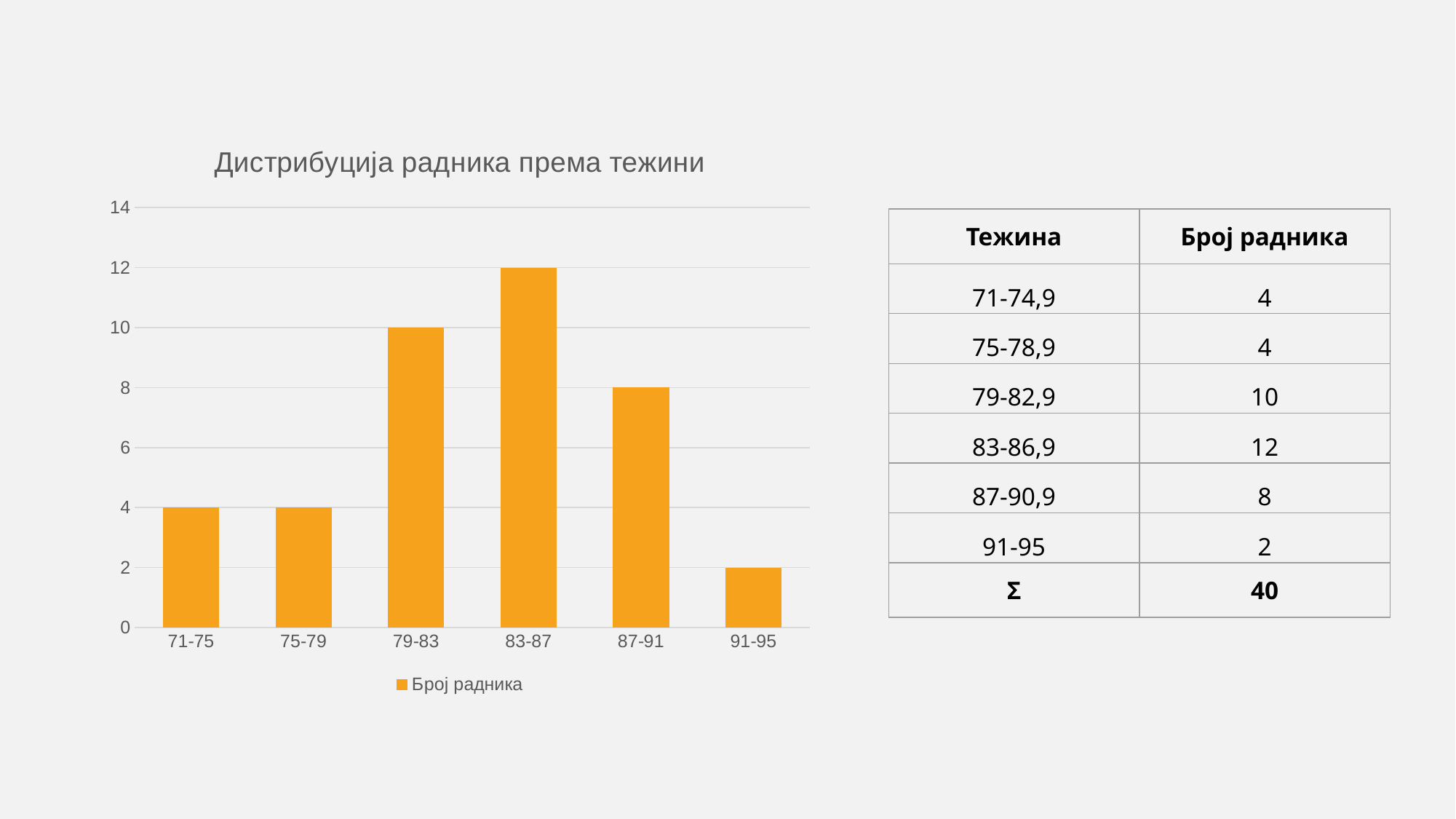
Which category has the highest value? 83-87 What is the value for the 79-83 category? 10 What is the value for the 83-87 category? 12 What is the title of the chart? Дистрибуција радника према тежини What is the value for the 91-95 category? 2 Which is larger, the value for 79-83 or the value for 87-91? 79-83 What kind of chart is shown? bar chart What is the difference between the values for 83-87 and 87-91? 4 Which category has the lowest value? 91-95 Is the value for 87-91 greater or less than 6? greater How many series does the legend list? 1 How many categories are shown on the x axis? 6